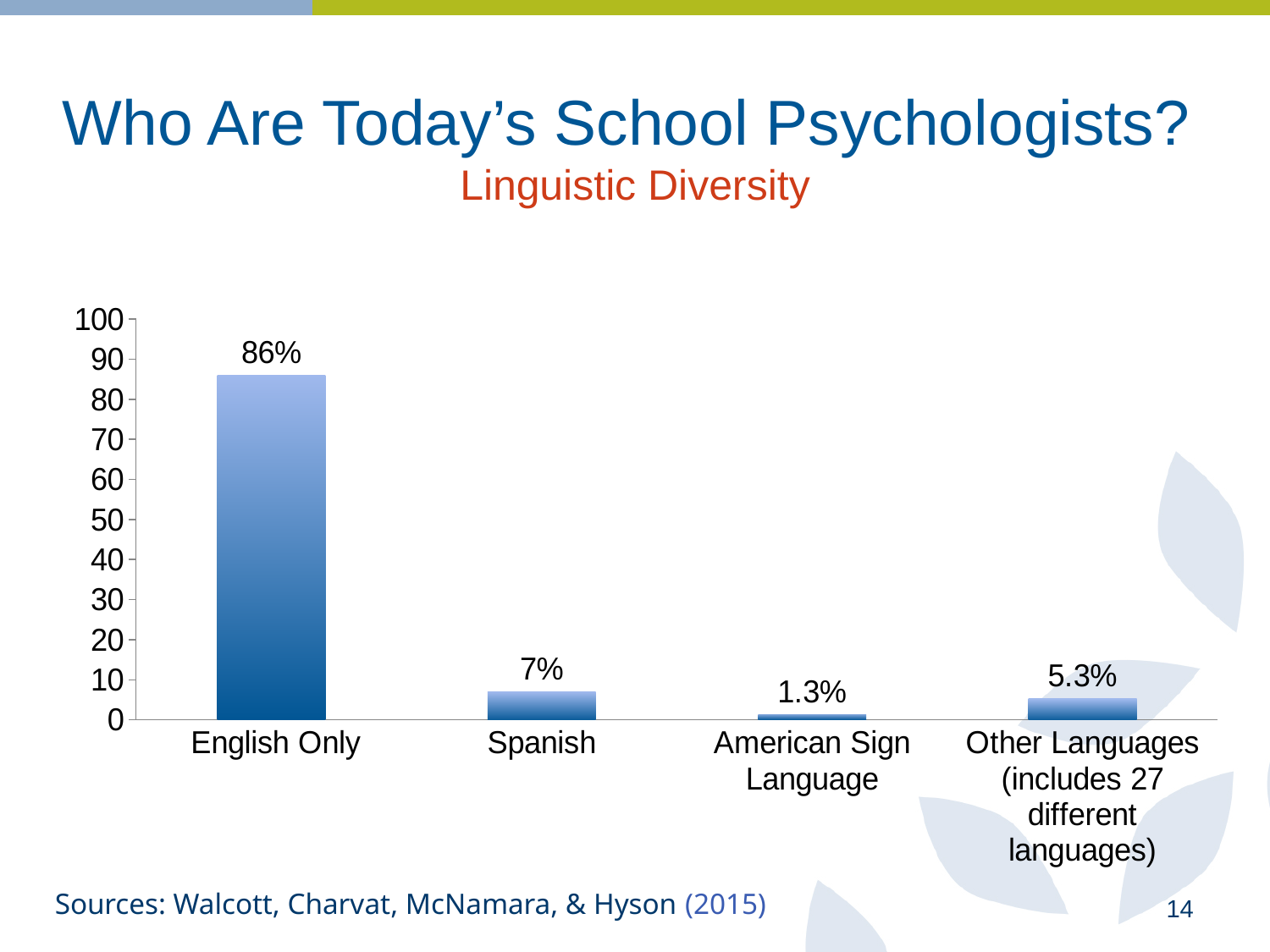
What is the difference between the values for English Only and Spanish? 79% What kind of chart is shown on the slide? bar chart How many categories are shown on the x axis? 4 What is the value for Spanish? 7% What is the difference between the values for Other Languages and American Sign Language? 4% Which category has the lowest value? American Sign Language What is the value for American Sign Language? 1.3% What is the value for English Only? 86% Which category has the highest value? English Only Which is larger, the value for Spanish or the value for Other Languages? Spanish What is the value for Other Languages (includes 27 different languages)? 5.3% Is the value for English Only greater or less than 80? greater